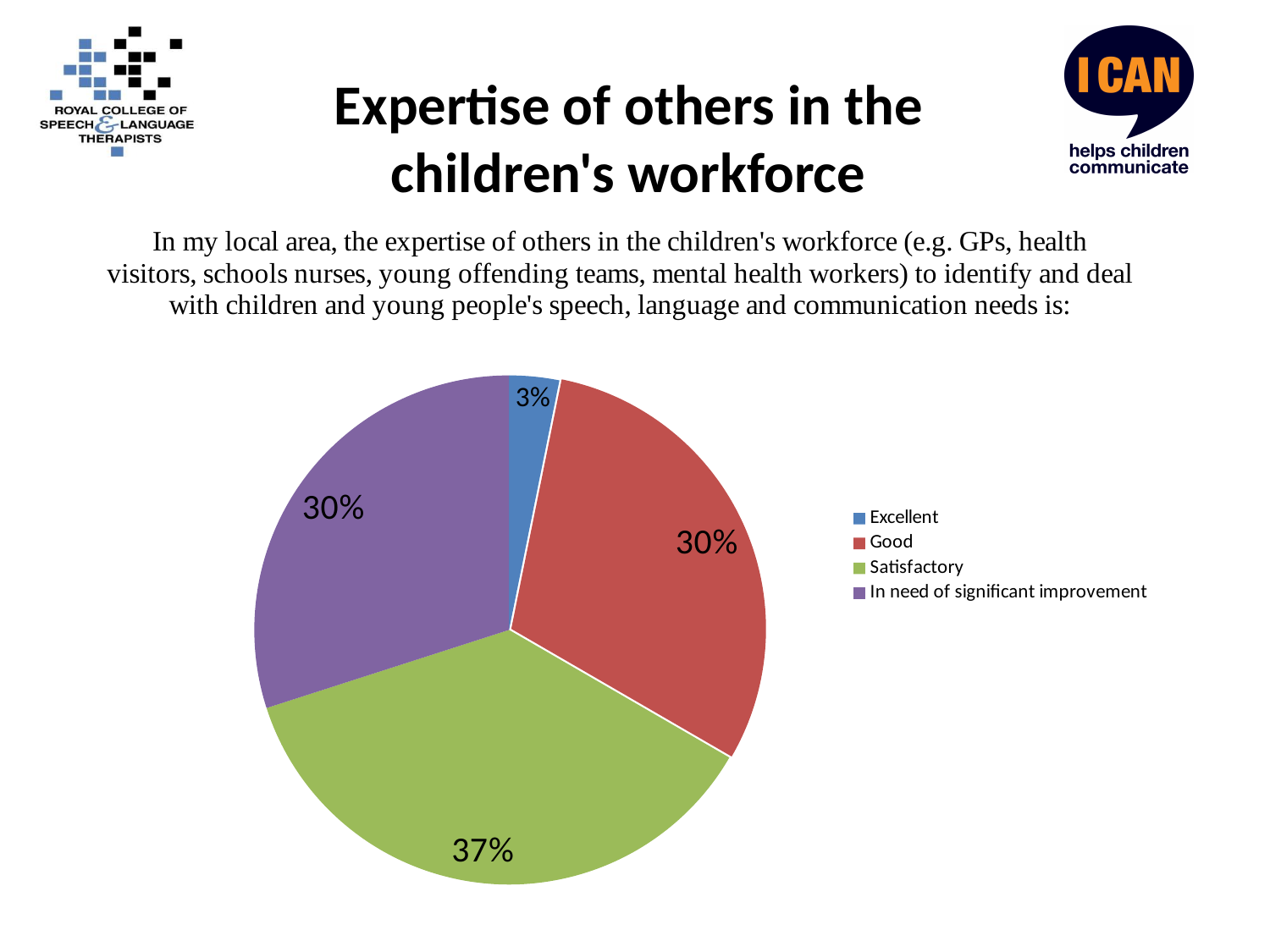
Which category has the largest slice of the pie? Satisfactory What share of the pie is labelled Good? 30% Which slice is larger, Satisfactory or Good? Satisfactory What kind of chart is shown on the slide? pie chart What colour is the Satisfactory slice? green What share of the pie is labelled Satisfactory? 37% What share of the pie is labelled Excellent? 3% Which category has the smallest slice of the pie? Excellent What is the title of the slide containing the chart? Expertise of others in the children's workforce How many categories does the legend list? 4 What is the difference in percentage points between the Satisfactory slice and the Excellent slice? 34